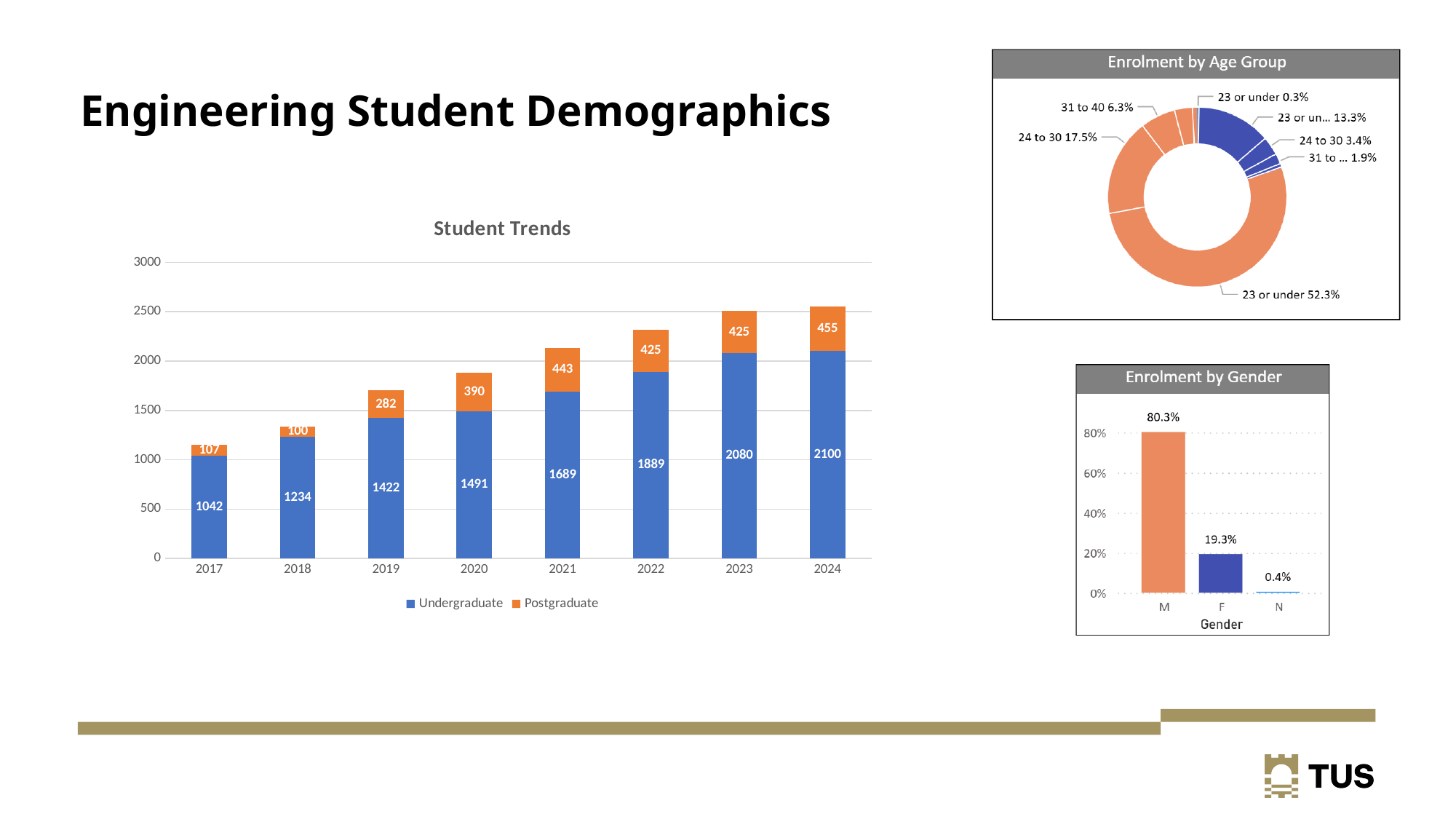
In the Student Trends chart, what is the total of the stacked bar for 2024? 2555 In the Student Trends chart, how many years are shown on the x axis? 8 In the Student Trends chart, do the Undergraduate values rise or fall from 2017 to 2024? rise In the Student Trends chart, how many series does the legend list? 2 What kind of chart is the Enrolment by Gender chart? bar chart In the Student Trends chart, what is the difference between the Undergraduate values for 2023 and 2017? 1038 In the Student Trends chart, what is the Undergraduate value for 2020? 1491 In the Enrolment by Gender chart, which gender category has the highest value? M In the Student Trends chart, which year has the lowest Postgraduate value? 2018 In the Student Trends chart, what is the Postgraduate value for 2021? 443 In the Enrolment by Gender chart, what is the value for F? 19.3% In the Enrolment by Age Group chart, what share does the largest slice, labelled 23 or under, have? 52.3%